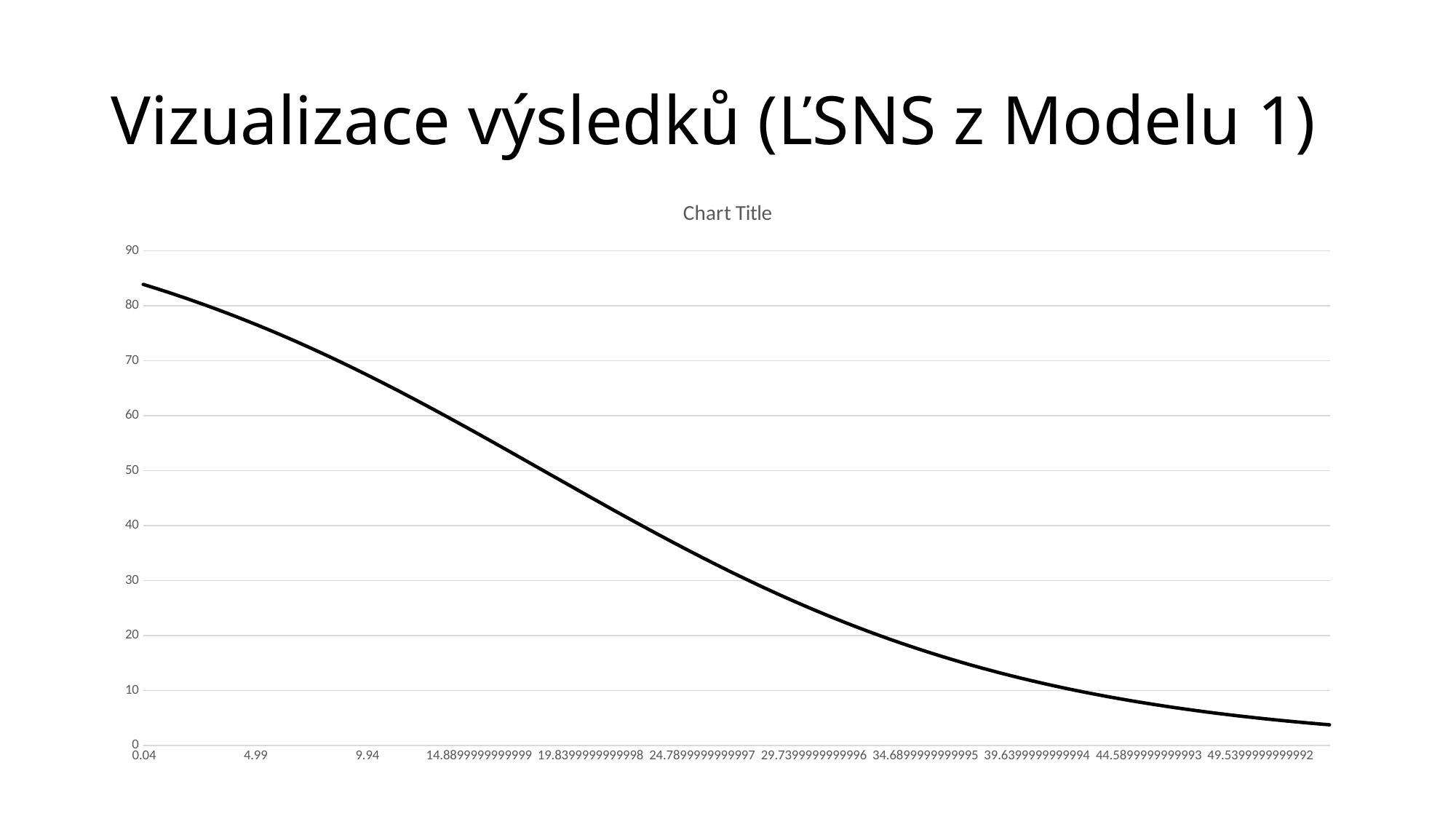
Is the value at x = 0.04 greater or less than 80? greater What kind of chart is shown on the slide? line chart Do the plotted values rise or fall as you move from left to right along the x axis? fall Is the value at x = 4.99 greater or less than 70? greater Is the value at x = 44.5899999999993 greater or less than 10? less At which labelled x-axis value is the line highest? 0.04 What is the title shown above the chart? Chart Title At which labelled x-axis value is the line lowest? 49.5399999999992